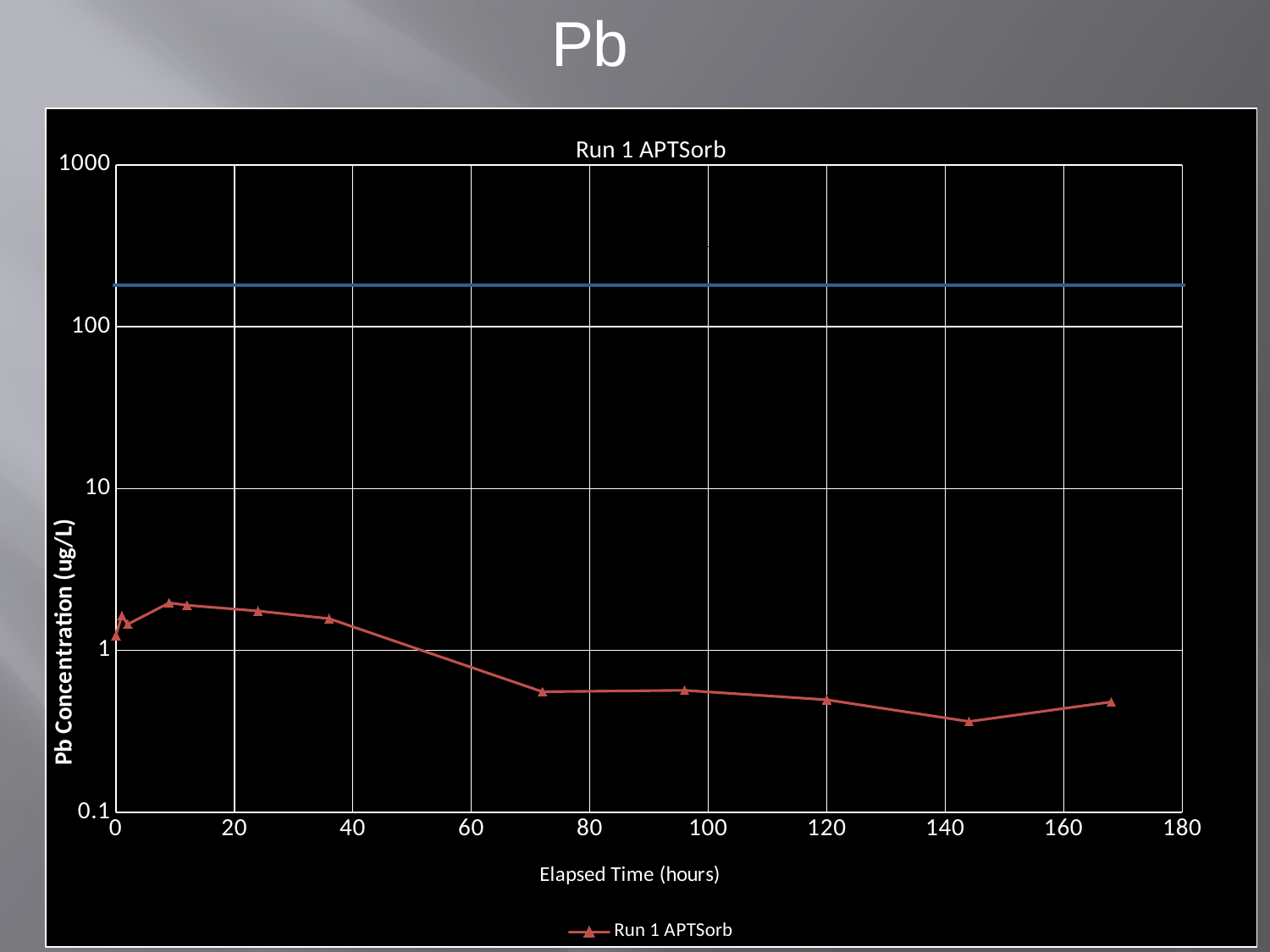
What is the title of the chart? Run 1 APTSorb How many series does the legend list? 1 Is the Pb concentration at 144 hours greater or less than 1 ug/L? less Overall, does the Pb concentration rise or fall as elapsed time increases from 12 to 144 hours? fall Which is larger, the Pb concentration at 36 hours or at 72 hours? 36 hours At which elapsed time is the Pb concentration for Run 1 APTSorb lowest? 144 hours What kind of chart is shown on the slide? line chart Is the Pb concentration at 72 hours greater or less than 1 ug/L? less Is the Pb concentration at 24 hours greater or less than 10 ug/L? less What is the label of the y axis? Pb Concentration (ug/L)